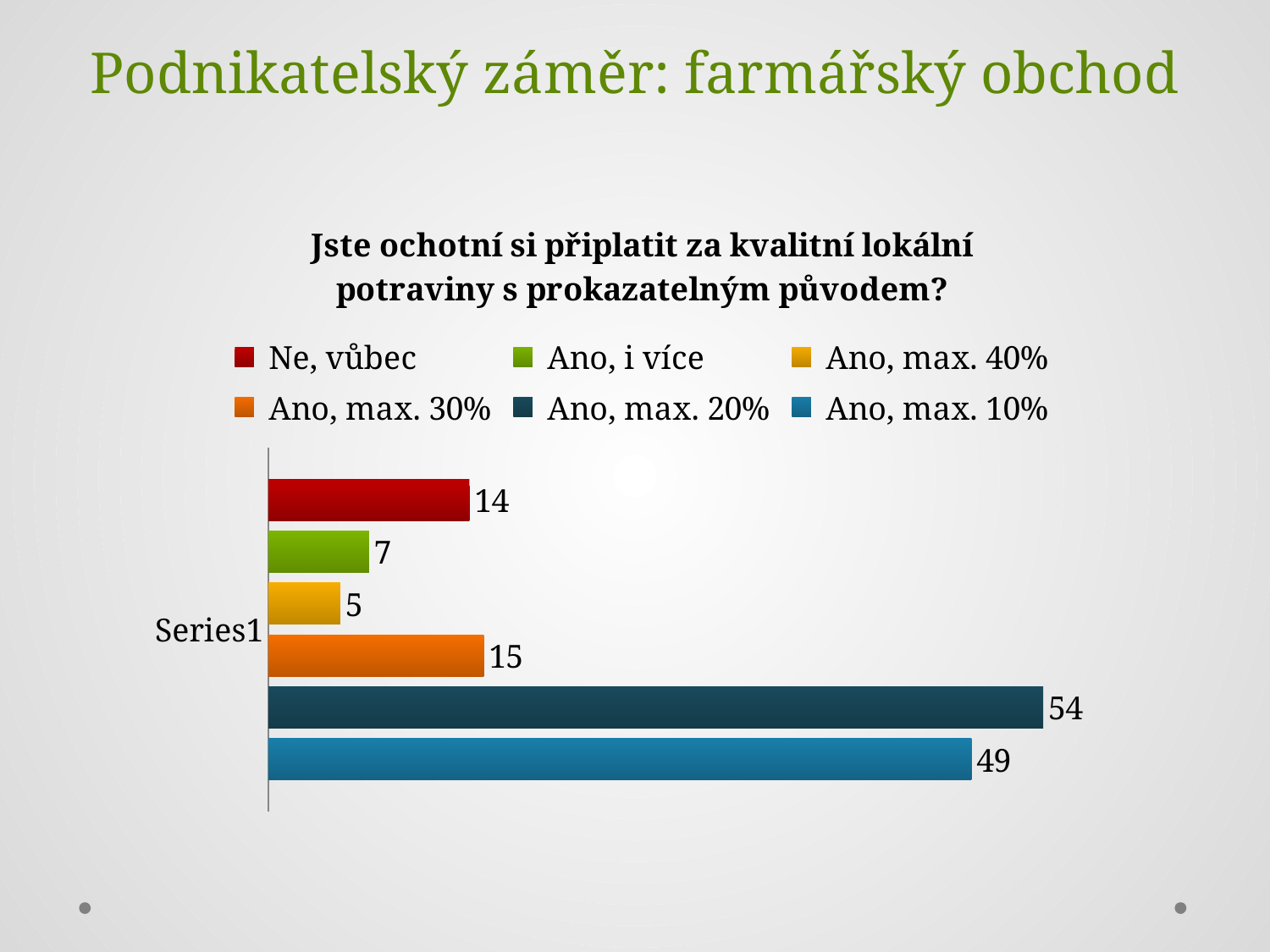
What kind of chart is shown on the slide? Bar chart How many series does the legend list? 6 What is the difference between the values for "Ano, max. 30%" and "Ano, i více"? 8 What value is shown for "Ano, max. 10%"? 49 What value is shown for "Ano, max. 40%"? 5 Which is larger, the value for "Ne, vůbec" or the value for "Ano, max. 30%"? Ano, max. 30% Which legend entry has the highest value? Ano, max. 20% What is the title of the chart? Jste ochotní si připlatit za kvalitní lokální potraviny s prokazatelným původem? What is the difference between the values for "Ano, max. 20%" and "Ano, max. 10%"? 5 Which legend entry has the lowest value? Ano, max. 40% What value is shown for "Ano, max. 20%"? 54 What value is shown for "Ne, vůbec"? 14